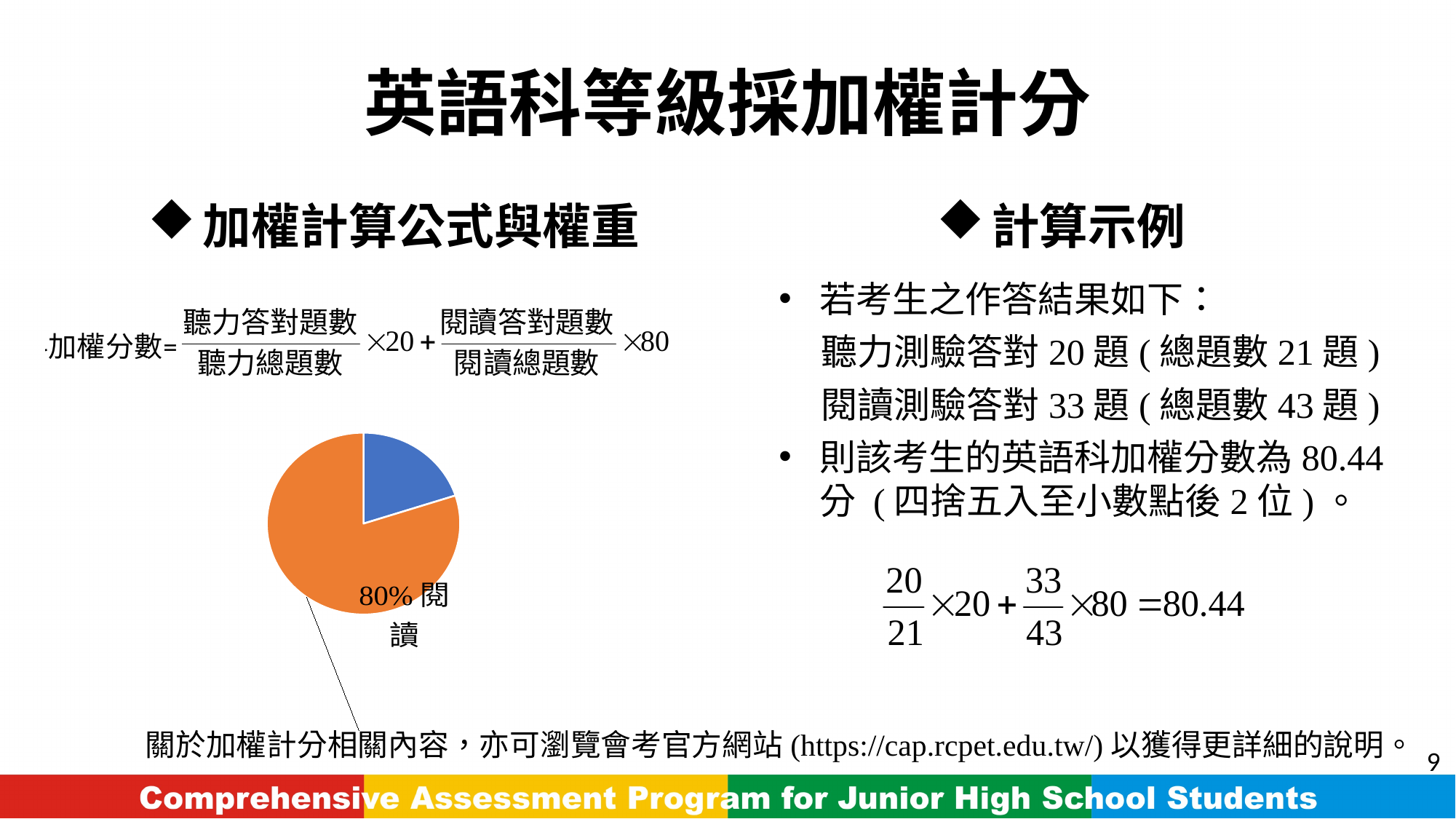
Does the 閱讀 slice take up more or less than half of the pie chart? more What share of the pie chart does the 閱讀 slice represent? 80% What colour is the 閱讀 slice in the pie chart? orange What kind of chart is shown on the slide? pie chart Which is larger in the pie chart, the orange slice or the blue slice? the orange slice Which slice of the pie chart carries a data label? 閱讀 (80%) How many slices does the pie chart have? 2 Which slice of the pie chart is the smallest? the blue slice Which slice of the pie chart is the largest? 閱讀